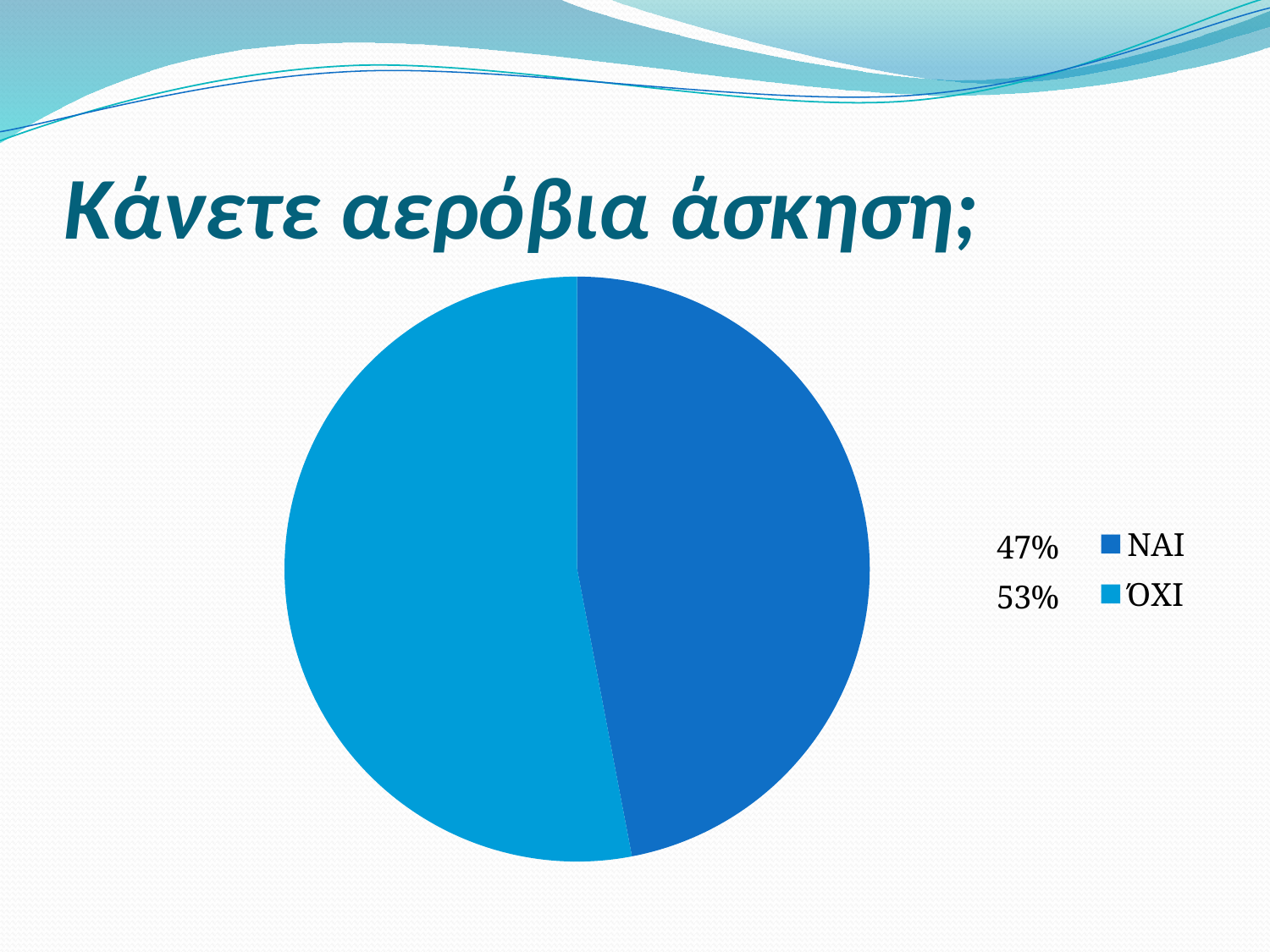
What is the title of the slide above the pie chart? Κάνετε αερόβια άσκηση; How many slices does the pie chart have? 2 What is the share for ΝΑΙ in the pie chart? 47% What is the share for ΌΧΙ in the pie chart? 53% What is the difference between the share for ΌΧΙ and the share for ΝΑΙ? 6% Which category has the largest slice of the pie chart? ΌΧΙ Which category has the smallest slice of the pie chart? ΝΑΙ How many entries does the legend list? 2 Which category is shown in the lighter blue colour in the pie chart? ΌΧΙ What kind of chart is shown on the slide? pie chart Which is larger, the share for ΝΑΙ or the share for ΌΧΙ? ΌΧΙ